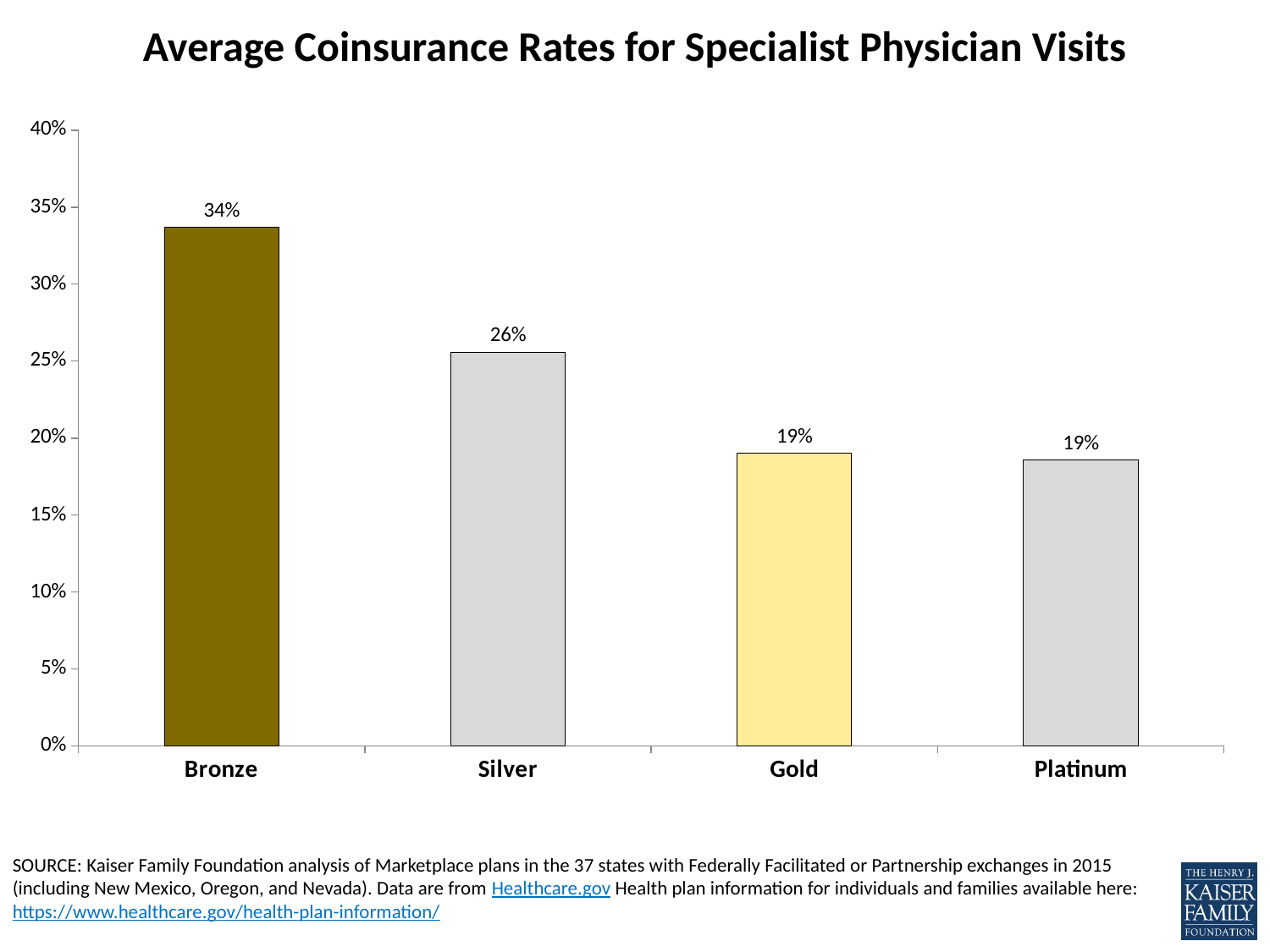
How many plan tiers are shown on the chart? 4 Which has a higher average coinsurance rate, Silver or Platinum? Silver What is the difference in average coinsurance rate between Silver and Gold plans? 7 percentage points What kind of chart is shown on the slide? Bar chart Which plan tier has the highest average coinsurance rate for specialist physician visits? Bronze What is the difference in average coinsurance rate between Bronze and Silver plans? 8 percentage points What is the average coinsurance rate for Silver plans? 26% What is the title of the chart? Average Coinsurance Rates for Specialist Physician Visits What is the average coinsurance rate for Gold plans? 19% What is the average coinsurance rate for Platinum plans? 19% Do the average coinsurance rates rise or fall moving from Bronze to Platinum? Fall What is the average coinsurance rate for Bronze plans? 34%